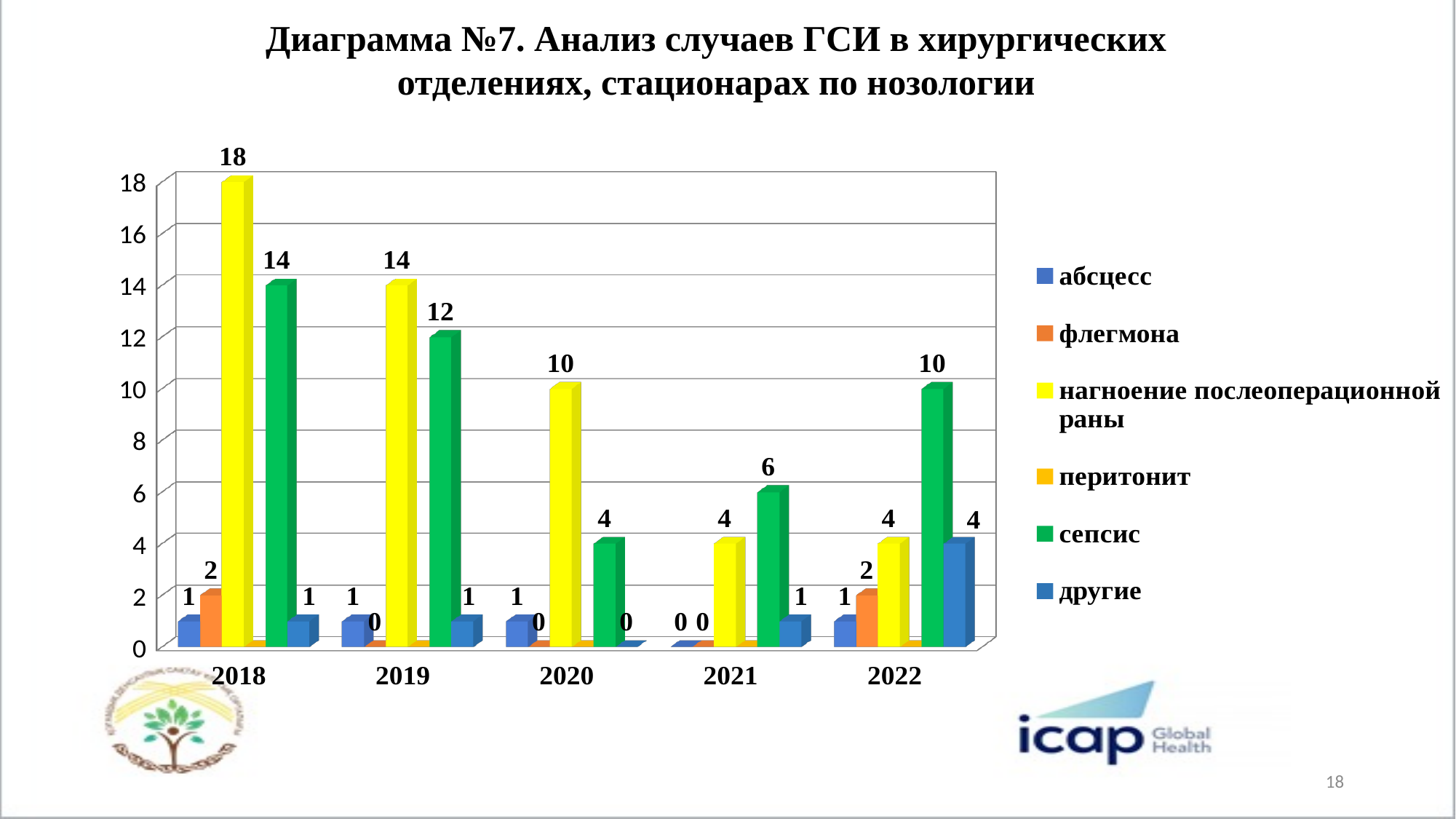
In which year is the value for нагноение послеоперационной раны the highest? 2018 In 2021, which is larger: нагноение послеоперационной раны or сепсис? сепсис Does the value for нагноение послеоперационной раны rise or fall from 2018 to 2021? fall How many series does the legend list? 6 What is the difference between the сепсис values in 2018 and 2022? 4 What is the value for нагноение послеоперационной раны in 2018? 18 What is the value for сепсис in 2022? 10 What is the value for флегмона in 2019? 0 How many years are shown on the x axis? 5 What is the value for другие in 2022? 4 In which year is the value for сепсис the lowest? 2020 What kind of chart is shown on the slide? bar chart